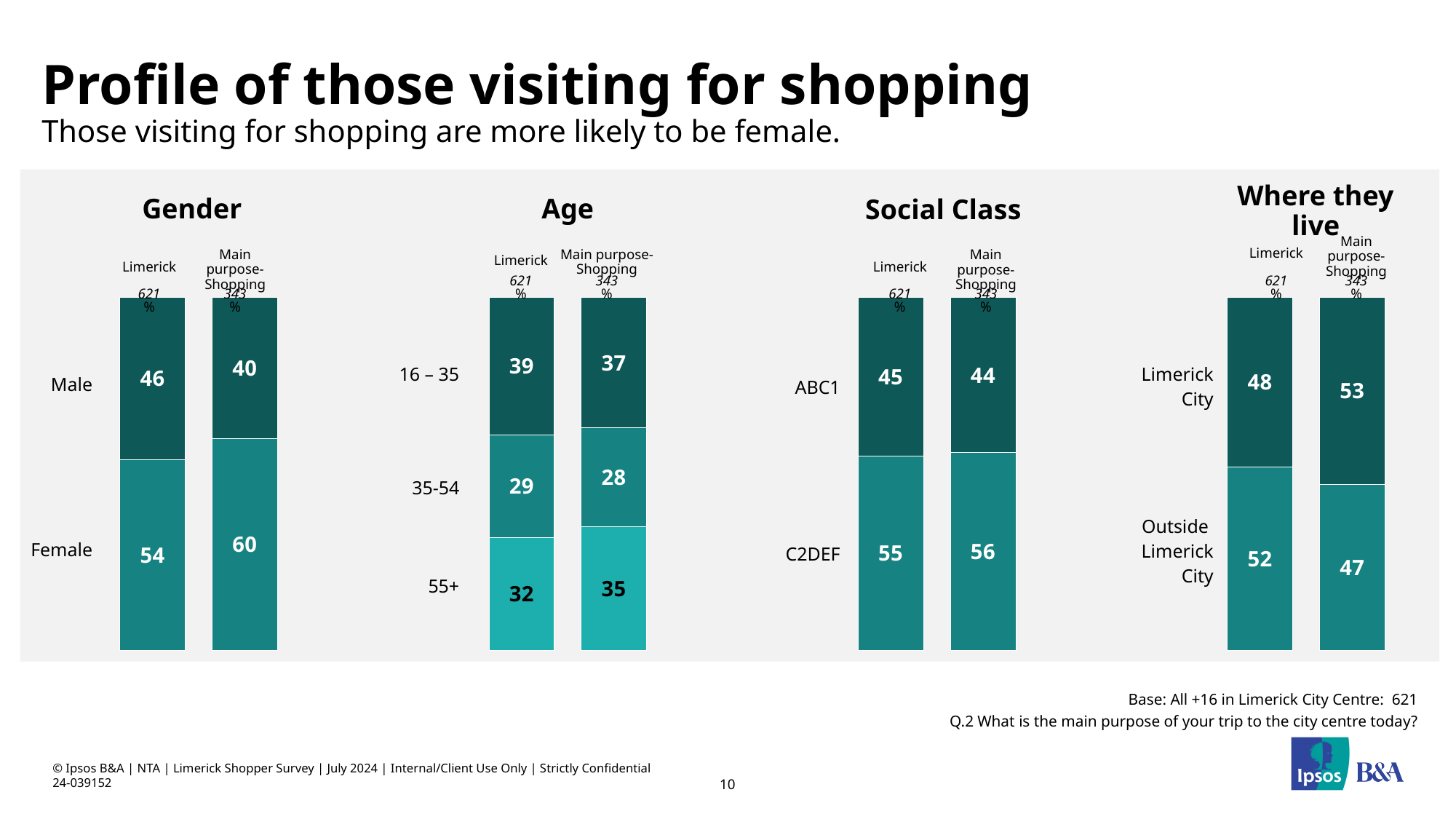
In the Age chart, which age group has the lowest value in the Main purpose-Shopping bar? 35-54 In the Gender chart, what percentage of the Main purpose-Shopping group is Female? 60 In the Age chart, which age group has the highest value in the Limerick bar? 16 – 35 What is the base size shown for the Limerick bar in each chart? 621 In the Where they live chart, which is larger for the Main purpose-Shopping bar: Limerick City or Outside Limerick City? Limerick City How many age groups are shown in the Age chart? 3 In the Where they live chart, what is the Outside Limerick City value for the Limerick bar? 52 What type of chart is used for the Social Class section? Stacked bar chart In the Gender chart, what is the total of the Limerick stacked bar (Male plus Female)? 100 In the Age chart, what is the 55+ value for the Main purpose-Shopping bar? 35 In the Social Class chart, what is the difference between the C2DEF value and the ABC1 value in the Main purpose-Shopping bar? 12 In the Gender chart, what is the Male value for the Limerick bar? 46